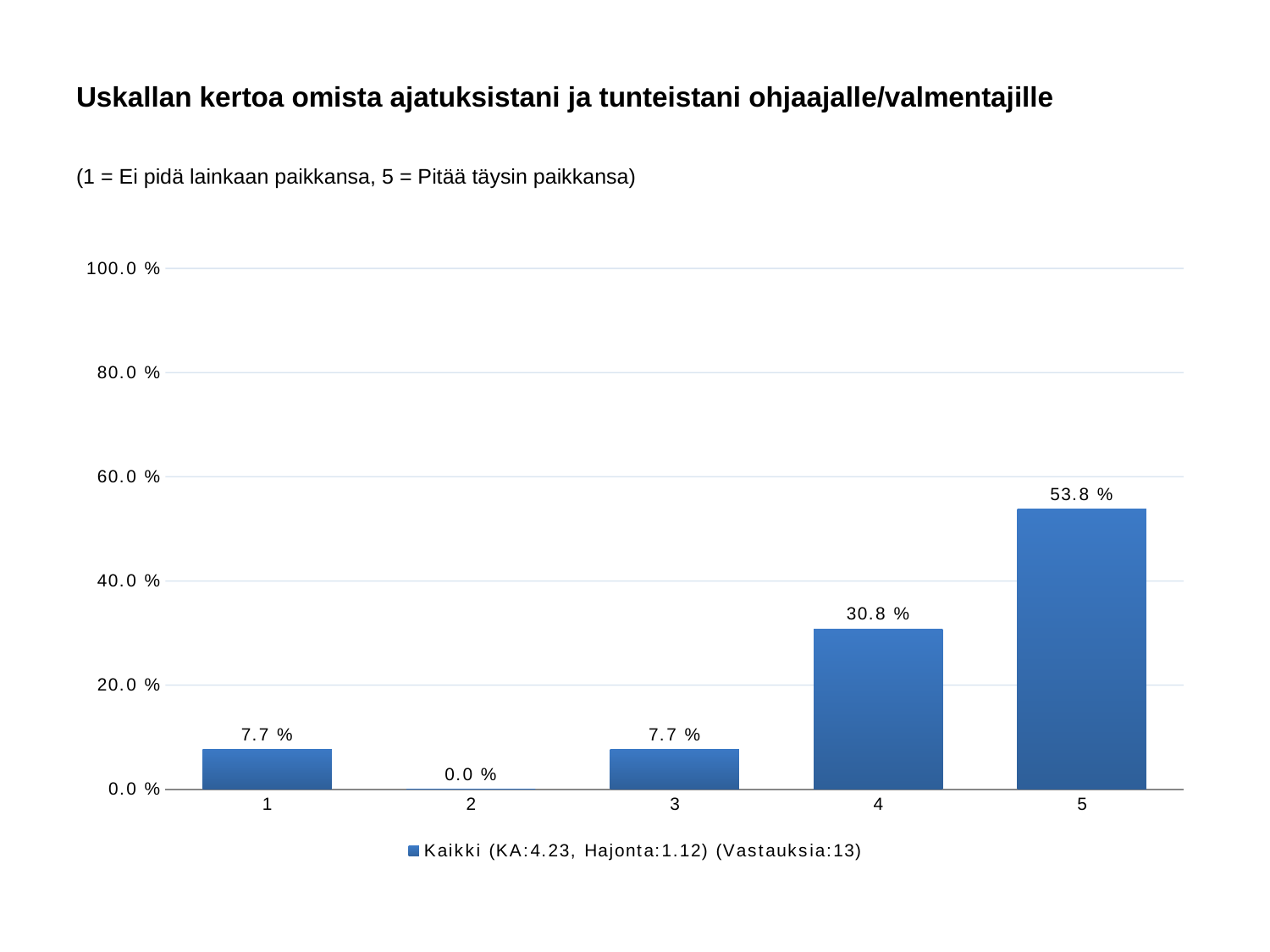
What is the difference between the values for category 5 and category 4? 23.0 % Which is larger, the value for category 3 or the value for category 4? 4 What kind of chart is shown on the slide? bar chart What is the value for category 2? 0.0 % How many series does the legend list? 1 What is the value for category 4? 30.8 % What is the value for category 1? 7.7 % How many categories are shown on the x axis? 5 Which category has the lowest value? 2 Is the value for category 5 greater or less than 40.0 %? greater What is the value for category 5? 53.8 % Which category has the highest value? 5